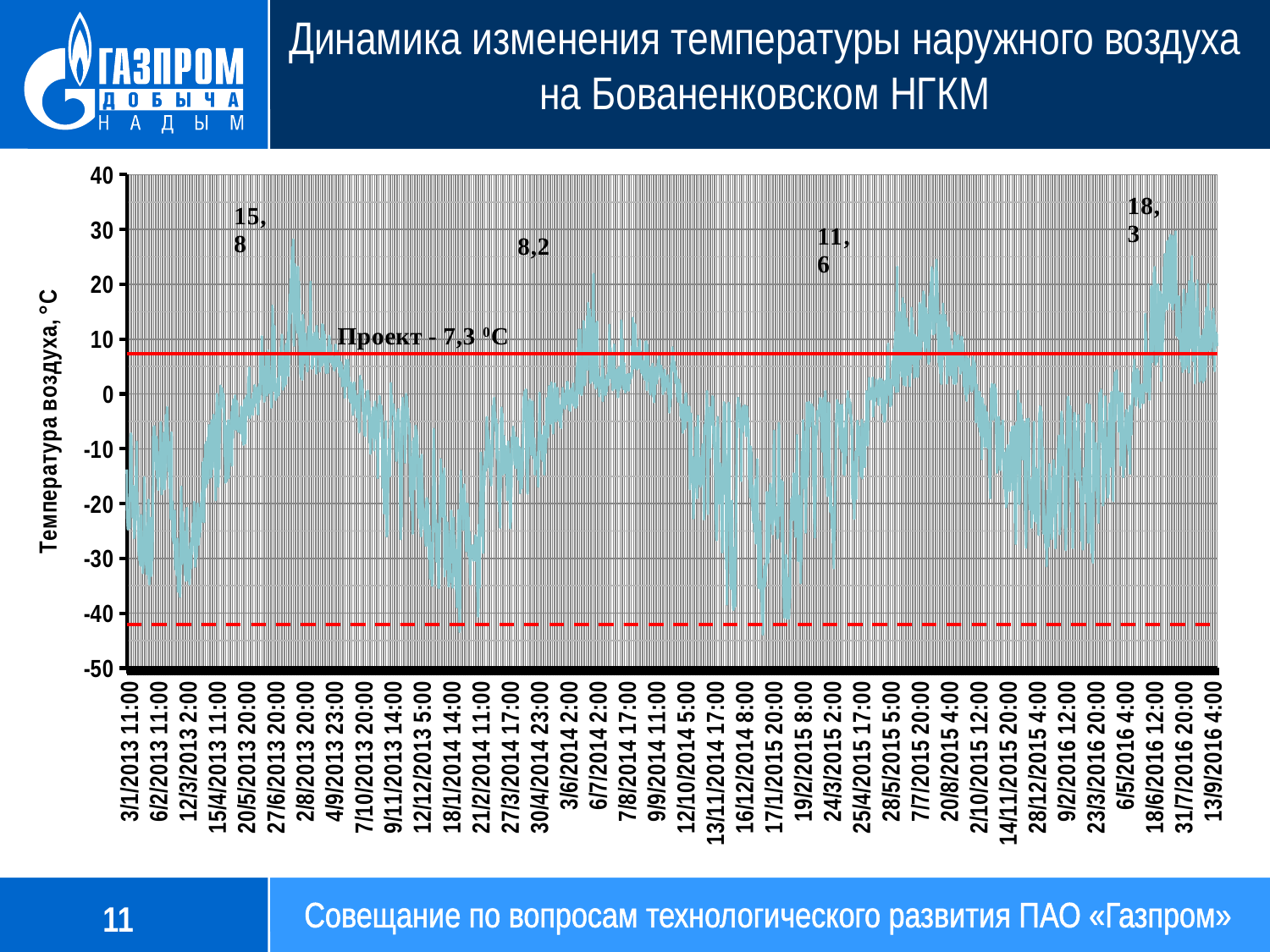
What project (Проект) temperature value is marked by the solid red horizontal line? 7,3 °C What is the title of the chart on the slide? Динамика изменения температуры наружного воздуха на Бованенковском НГКМ What is the lowest value shown on the vertical axis of the chart? -50 What is the label of the vertical axis of the chart? Температура воздуха, °C Which of the four annotated values printed above the line (15,8; 8,2; 11,6; 18,3) is the largest? 18,3 Which of the four annotated values printed above the line (15,8; 8,2; 11,6; 18,3) is the smallest? 8,2 What is the first date-time label on the horizontal axis? 3/1/2013 11:00 Is the temperature around 17/1/2015 20:00 greater or less than -20? less What kind of chart is shown on the slide? line chart What is the highest value shown on the vertical axis of the chart? 40 What is the last date-time label on the horizontal axis? 13/9/2016 4:00